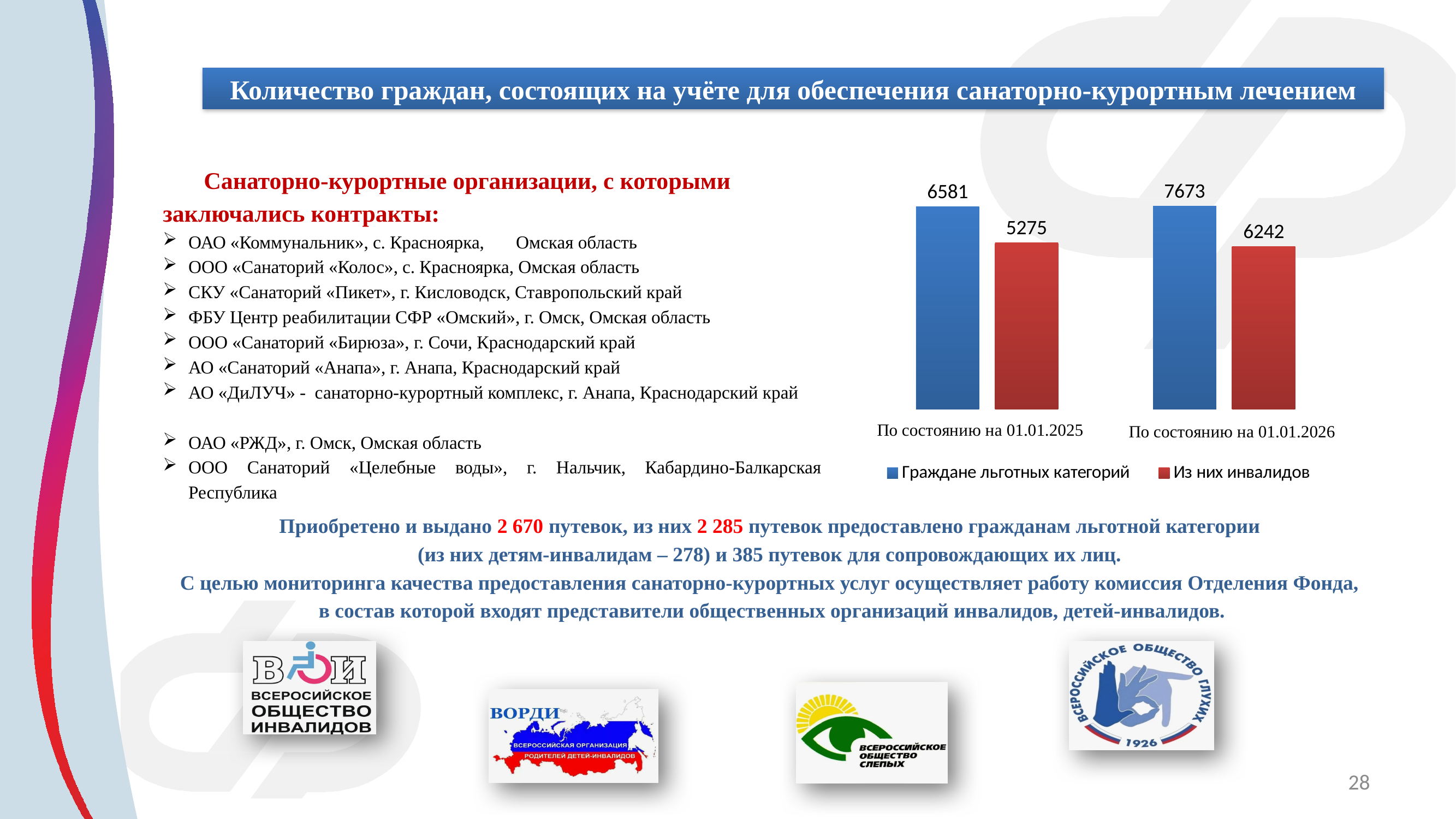
How many series does the legend list? 2 What is the value for «Из них инвалидов» as of 01.01.2026? 6242 Does the value for «Граждане льготных категорий» rise or fall from 01.01.2025 to 01.01.2026? Rise What kind of chart is shown on the slide? Bar chart Which bar has the lowest value on the chart? Из них инвалидов, по состоянию на 01.01.2025 By how much did «Граждане льготных категорий» change from 01.01.2025 to 01.01.2026? 1092 What is the value for «Из них инвалидов» as of 01.01.2025? 5275 What is the difference between «Граждане льготных категорий» and «Из них инвалидов» as of 01.01.2026? 1431 Which is larger: «Из них инвалидов» as of 01.01.2025 or as of 01.01.2026? 01.01.2026 Which bar has the highest value on the chart? Граждане льготных категорий, по состоянию на 01.01.2026 What is the value for «Граждане льготных категорий» as of 01.01.2026? 7673 What is the value for «Граждане льготных категорий» as of 01.01.2025? 6581